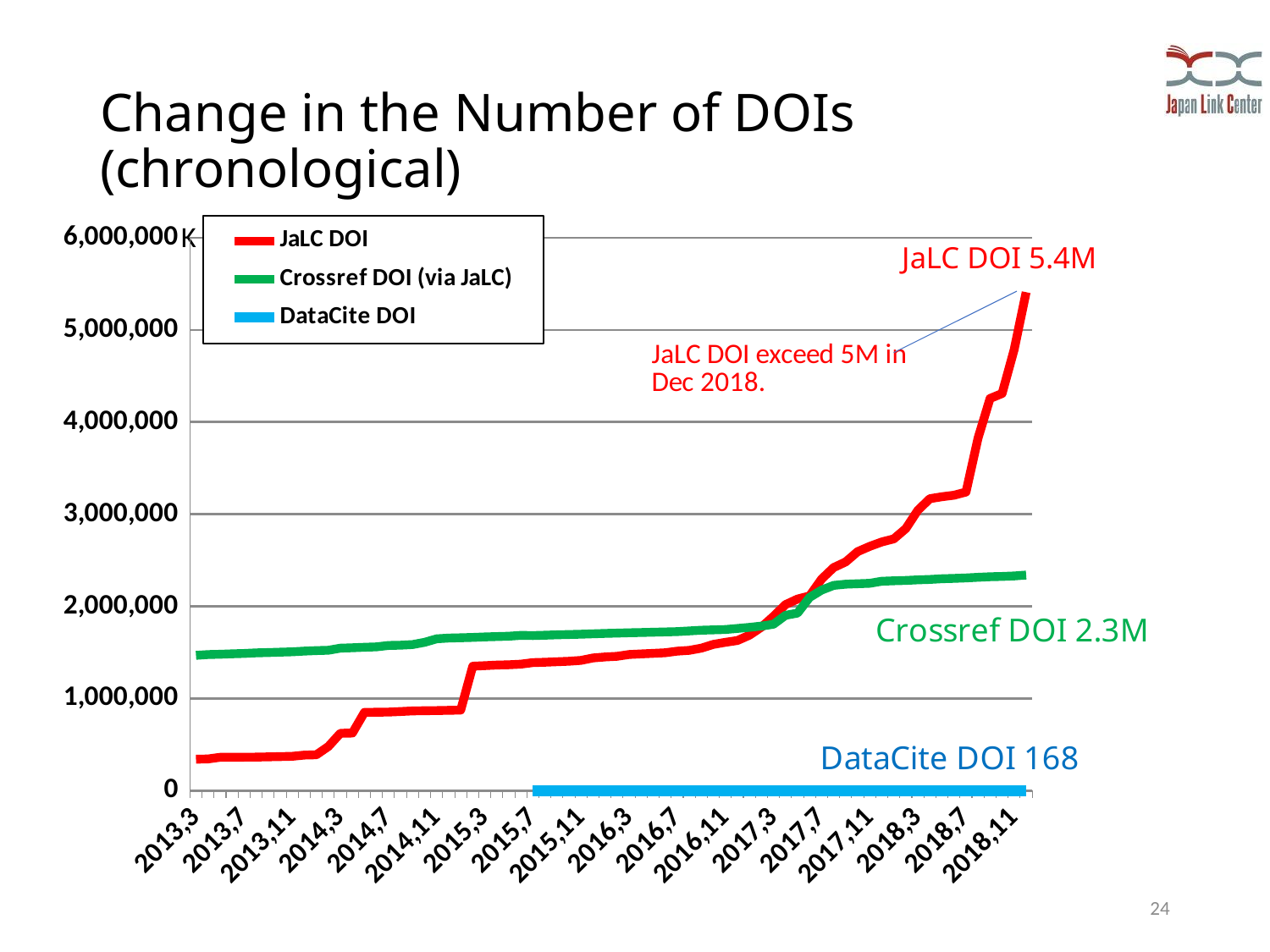
Does the JaLC DOI series rise or fall over time along the x axis? rise How many series does the legend list? 3 Which series has the highest value at the end of the chart (2018.11)? JaLC DOI Is the Crossref DOI (via JaLC) value at 2013.3 greater or less than 1,000,000? greater What kind of chart is shown on the slide? line chart Is the JaLC DOI value at 2013.3 greater or less than 1,000,000? less According to the annotation, in which month did JaLC DOIs exceed 5M? Dec 2018 At 2016.3, which is larger: JaLC DOI or Crossref DOI (via JaLC)? Crossref DOI (via JaLC) According to the annotation, what is the number of DataCite DOIs? 168 According to the annotation, what is the latest number of JaLC DOIs? 5.4M Which series has the lowest value at the end of the chart (2018.11)? DataCite DOI According to the annotation, what is the latest number of Crossref DOIs (via JaLC)? 2.3M